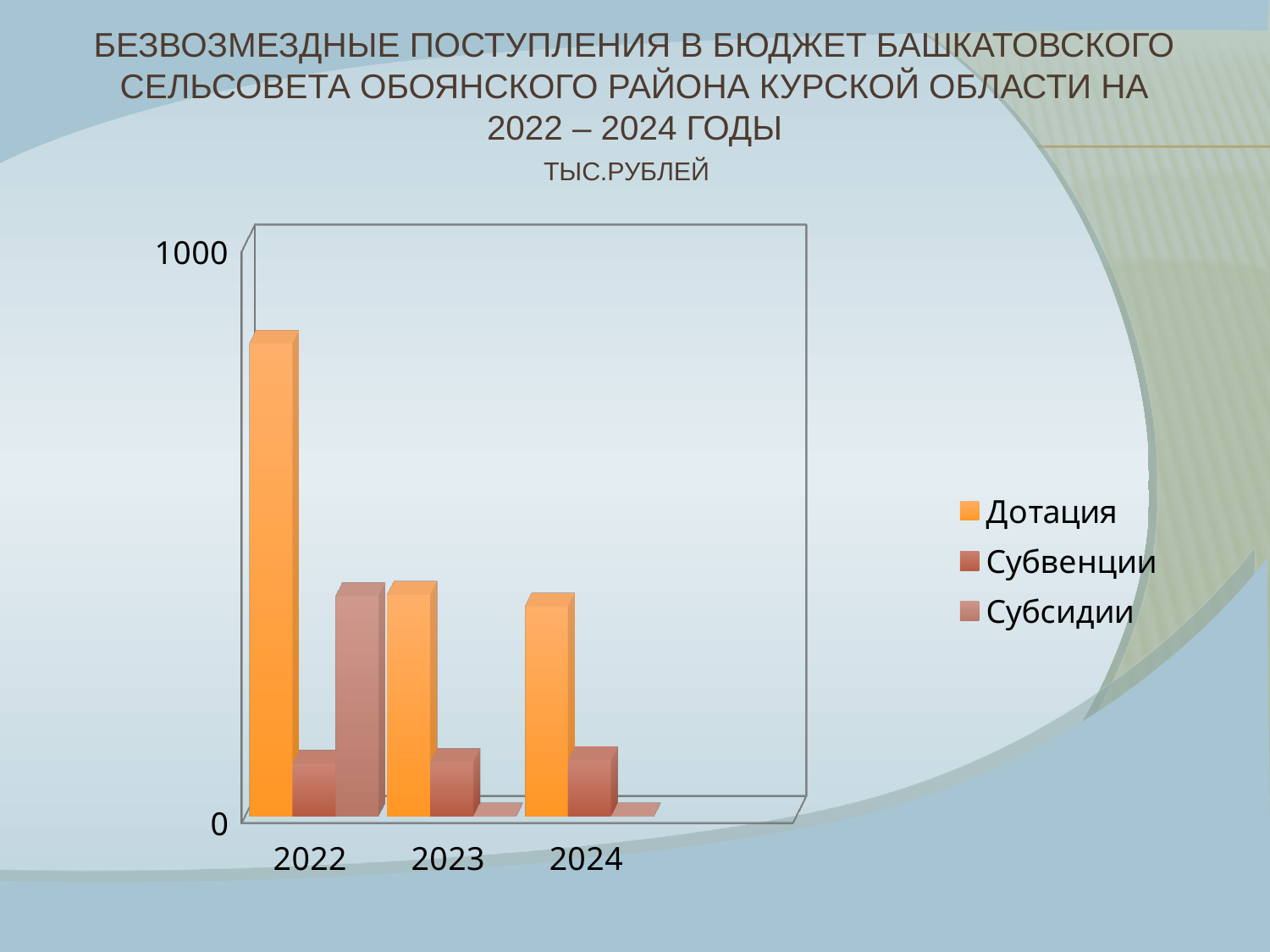
In which year is the value for Субсидии highest? 2022 Which series has the highest value in 2022? Дотация Do the values for Дотация rise or fall from 2022 to 2024? fall Which is larger in 2022, Дотация or Субвенции? Дотация How many series does the legend list? 3 In which year is the value for Дотация highest? 2022 Which series has the lowest value in 2023? Субсидии What unit of measurement is stated under the chart title? ТЫС.РУБЛЕЙ Is the value for Дотация in 2022 greater or less than 1000? less Which is larger in 2022, Субсидии or Субвенции? Субсидии How many years (categories) are shown on the x axis? 3 What kind of chart is shown on the slide? Bar chart